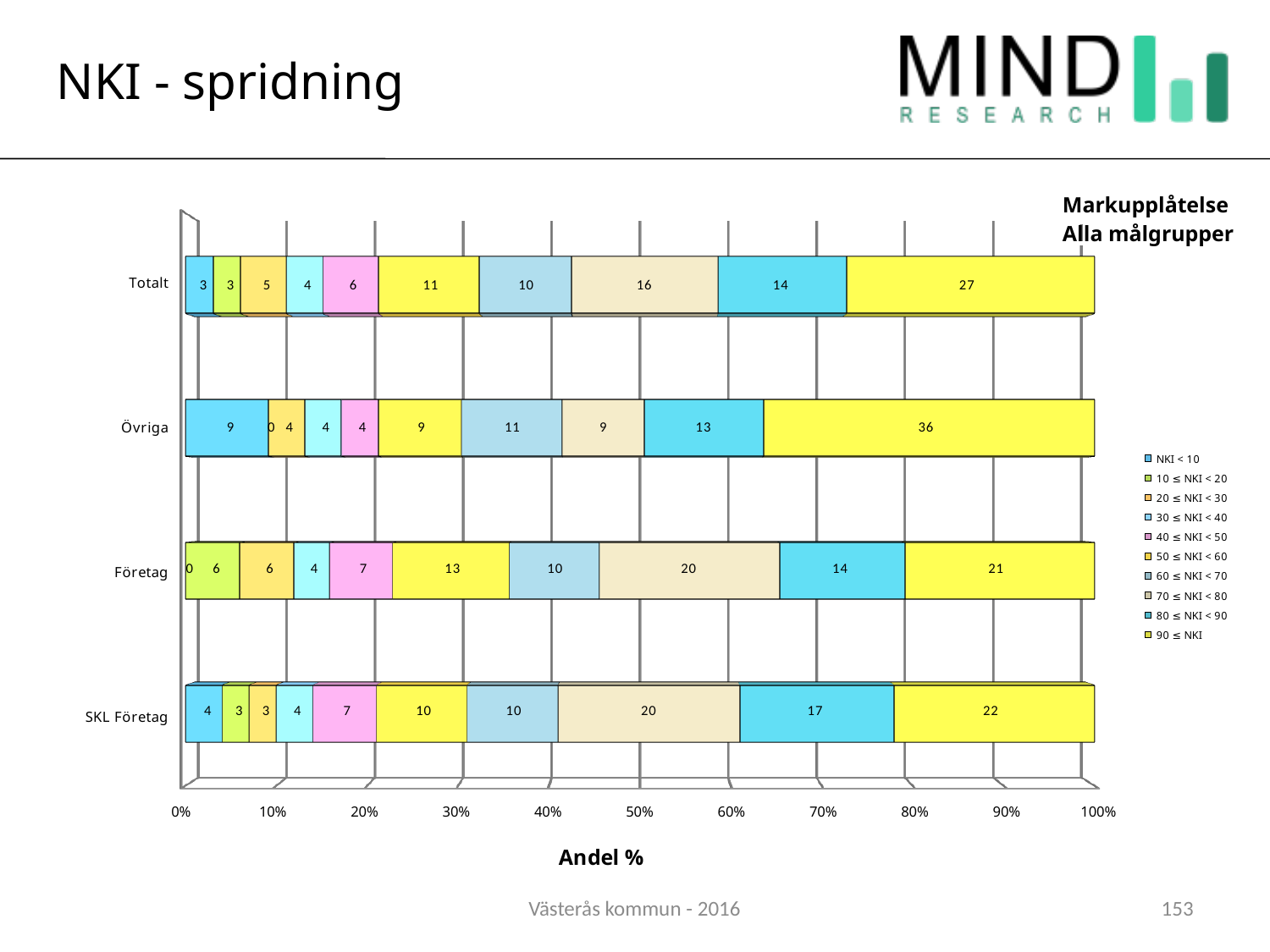
Which category has the largest 90 ≤ NKI segment? Övriga What is the difference between the 90 ≤ NKI segment for Totalt and for Företag? 6 Which category has the smallest 90 ≤ NKI segment? Företag Which is larger, the 80 ≤ NKI < 90 segment for SKL Företag or for Företag? SKL Företag What kind of chart is shown on the slide? Stacked bar chart What is the title of the x axis? Andel % What is the value of the 80 ≤ NKI < 90 segment for SKL Företag? 17 How many categories are shown on the y axis of the chart? 4 How many series does the legend list? 10 What is the value of the 90 ≤ NKI segment for Övriga? 36 What is the value of the 70 ≤ NKI < 80 segment for Företag? 20 What is the value of the NKI < 10 segment for Övriga? 9